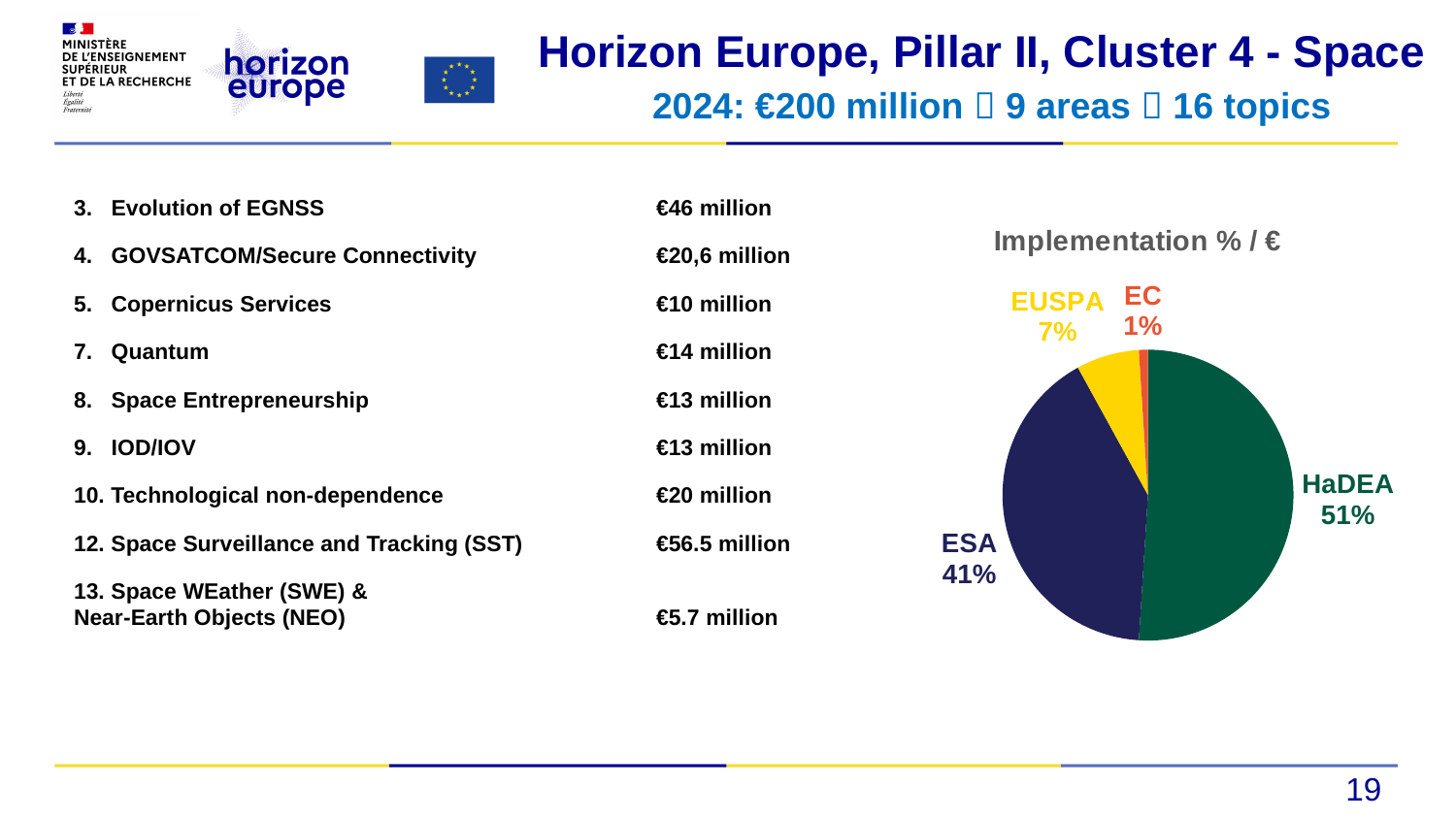
Which is larger, the EUSPA slice or the EC slice? EUSPA Which slice of the pie is the smallest? EC What share of the pie does ESA hold? 41% What colour is the HaDEA slice of the pie? green What is the title of the chart? Implementation % / € What share of the pie does HaDEA hold? 51% What is the difference in percentage points between the HaDEA and ESA slices? 10 Which slice of the pie is the largest? HaDEA What share of the pie does EUSPA hold? 7% How many slices does the pie chart have? 4 What kind of chart is shown on the slide? pie chart